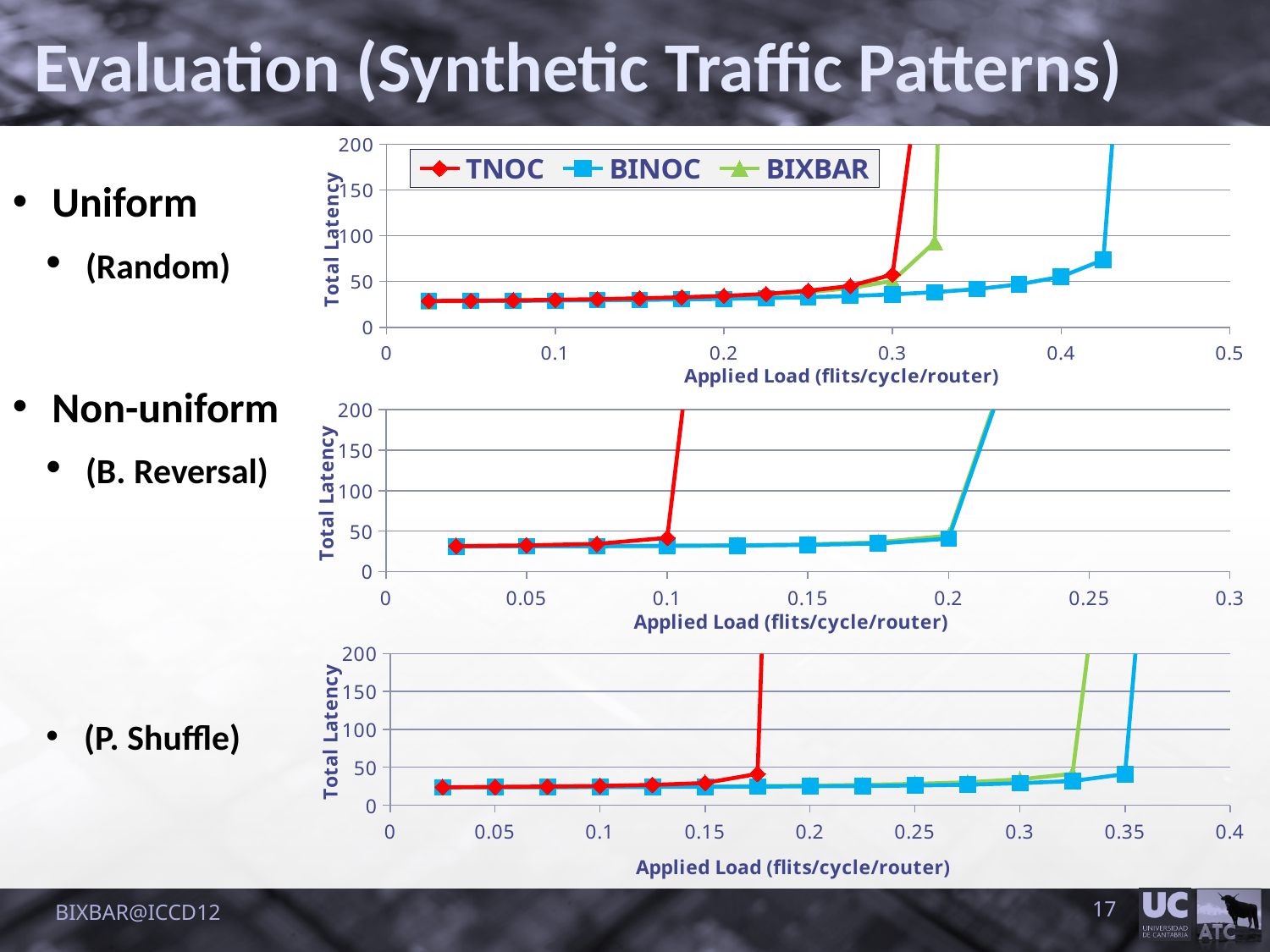
What kind of chart is the top chart on the slide? line chart What are the series names listed in the legend of the top chart? TNOC, BINOC, BIXBAR What is the y-axis title of the charts on the slide? Total Latency How many series does the legend on the top chart list? 3 In the middle chart, is the TNOC value at an applied load of 0.1 greater or less than 100? less In the top chart, does the TNOC total latency rise or fall as applied load increases? rise In the top chart, is the TNOC value at an applied load of 0.3 greater or less than 100? less In the top chart, is the BINOC value at an applied load of 0.4 greater or less than 100? less In the top chart, at an applied load of 0.3, which series has the higher total latency, TNOC or BINOC? TNOC In the middle chart, which series reaches a total latency of 200 at the lowest applied load? TNOC In the bottom chart, which series reaches a total latency of 200 at the lowest applied load? TNOC